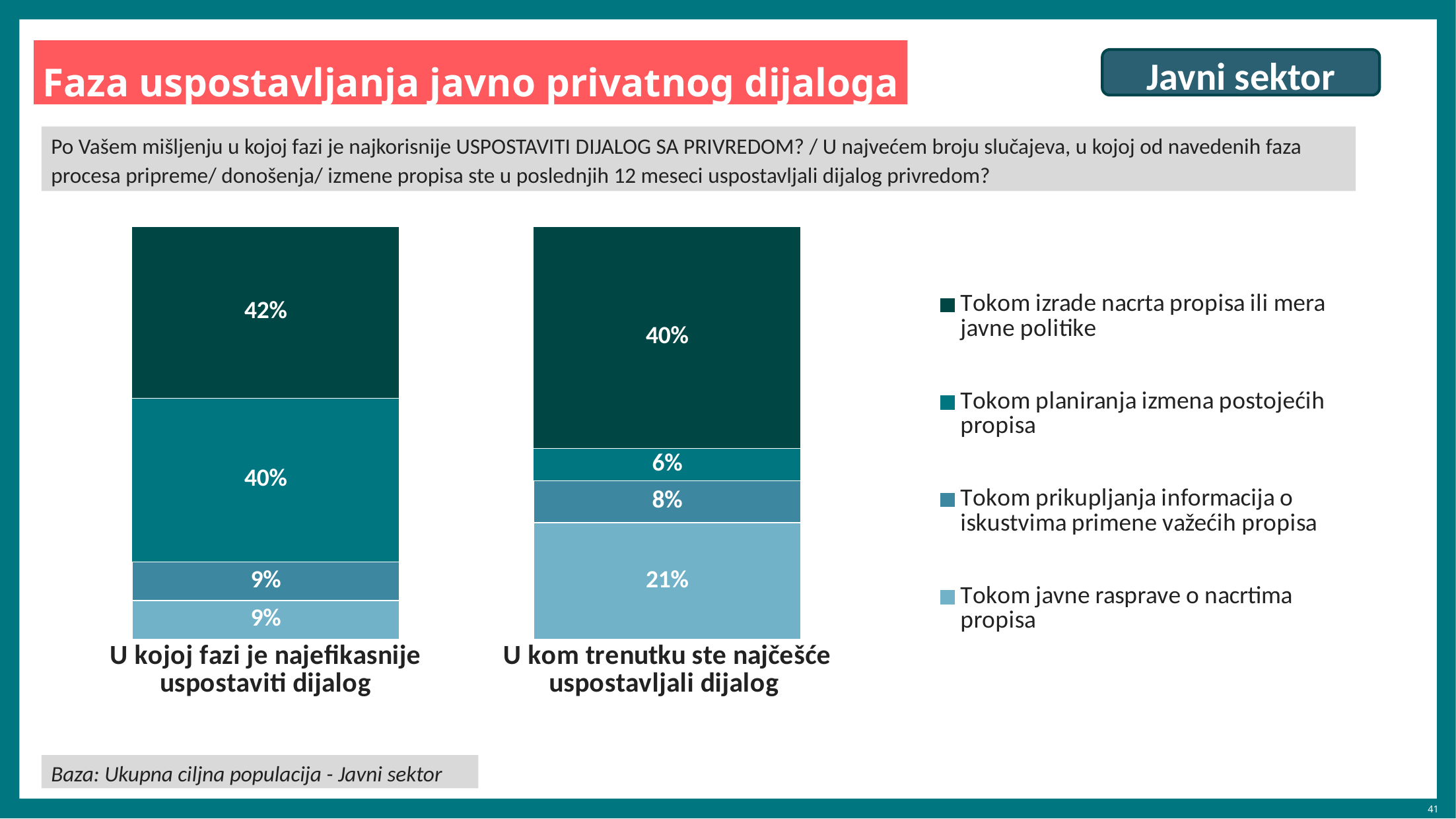
What is the total of the stacked bar "U kom trenutku ste najčešće uspostavljali dijalog"? 75% What is the value for "Tokom izrade nacrta propisa ili mera javne politike" in the bar "U kojoj fazi je najefikasnije uspostaviti dijalog"? 42% What is the value for "Tokom prikupljanja informacija o iskustvima primene važećih propisa" in the bar "U kojoj fazi je najefikasnije uspostaviti dijalog"? 9% What is the value for "Tokom javne rasprave o nacrtima propisa" in the bar "U kom trenutku ste najčešće uspostavljali dijalog"? 21% How many bars (categories) are plotted in the chart? 2 How many series does the legend list? 4 Which series has the lowest value in the bar "U kom trenutku ste najčešće uspostavljali dijalog"? Tokom planiranja izmena postojećih propisa Which bar has the larger value for "Tokom javne rasprave o nacrtima propisa"? U kom trenutku ste najčešće uspostavljali dijalog What is the value for "Tokom planiranja izmena postojećih propisa" in the bar "U kom trenutku ste najčešće uspostavljali dijalog"? 6% Which series has the highest value in the bar "U kom trenutku ste najčešće uspostavljali dijalog"? Tokom izrade nacrta propisa ili mera javne politike What is the difference between the "Tokom planiranja izmena postojećih propisa" values in the two bars (40% vs 6%)? 34 percentage points What kind of chart is shown on the slide? stacked bar chart